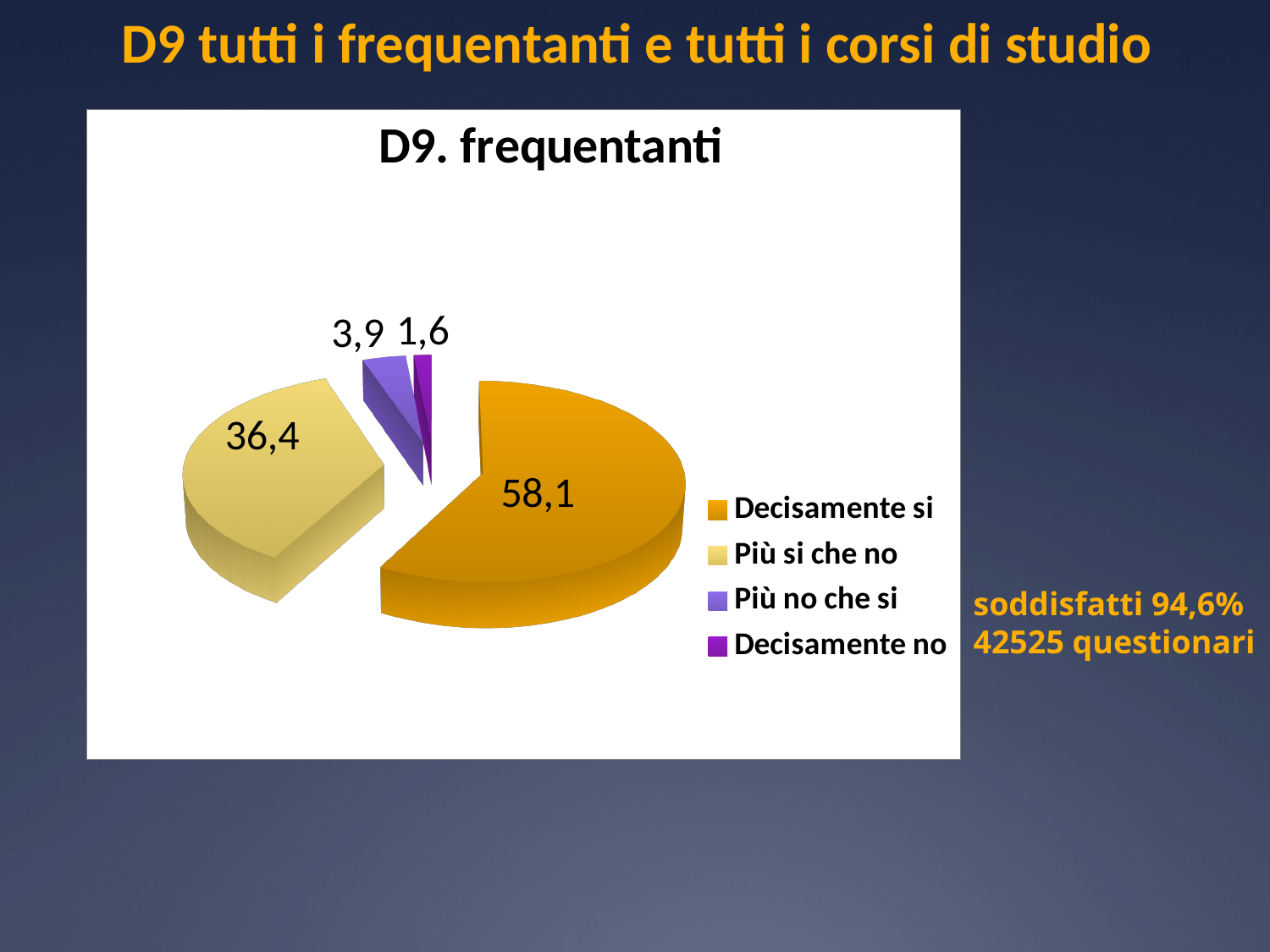
What is the title of the chart? D9. frequentanti What is the value for Decisamente no? 1,6 Which category has the smallest slice of the pie? Decisamente no What is the value for Decisamente si? 58,1 How many categories does the pie chart have? 4 What is the difference between the values for Decisamente si and Più si che no? 21,7 What is the value for Più si che no? 36,4 What is the value for Più no che si? 3,9 Which category has the largest slice of the pie? Decisamente si Which is larger, the value for Più no che si or the value for Decisamente no? Più no che si What colour is the slice for Decisamente si? orange What kind of chart is shown on the slide? pie chart